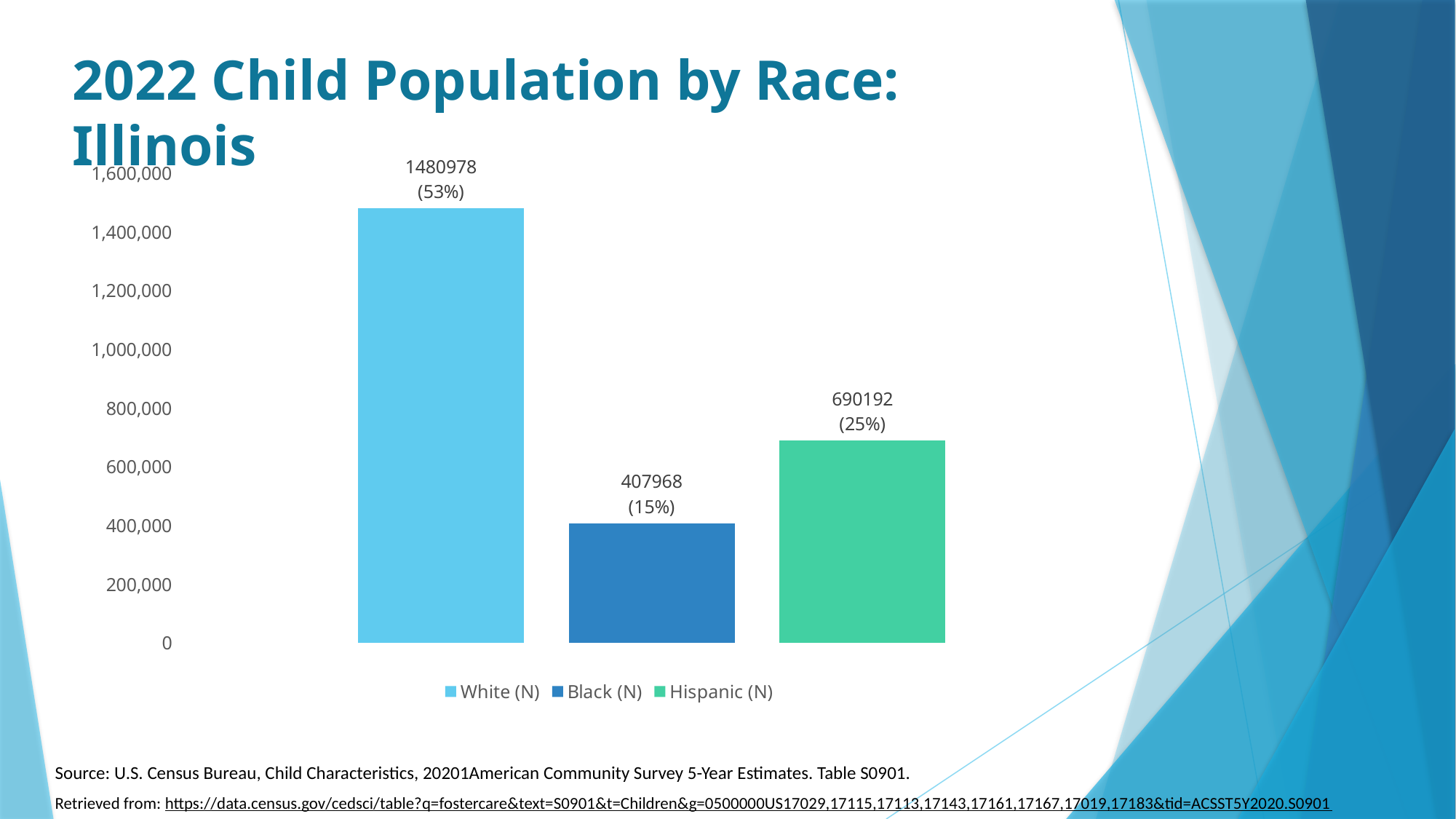
How many entries does the legend list? 3 What is the value shown for White (N)? 1480978 Which is larger, the value for Hispanic (N) or the value for Black (N)? Hispanic (N) Which group has the lowest child population? Black (N) How many bars are plotted in the chart? 3 What is the difference between the values for Hispanic (N) and Black (N)? 282224 Is the value for White (N) greater or less than 1,400,000? greater Which group has the highest child population? White (N) What is the value shown for Black (N)? 407968 What is the difference between the values for White (N) and Hispanic (N)? 790786 What percentage is shown for Hispanic (N)? 25% What kind of chart is shown on the slide? Bar chart